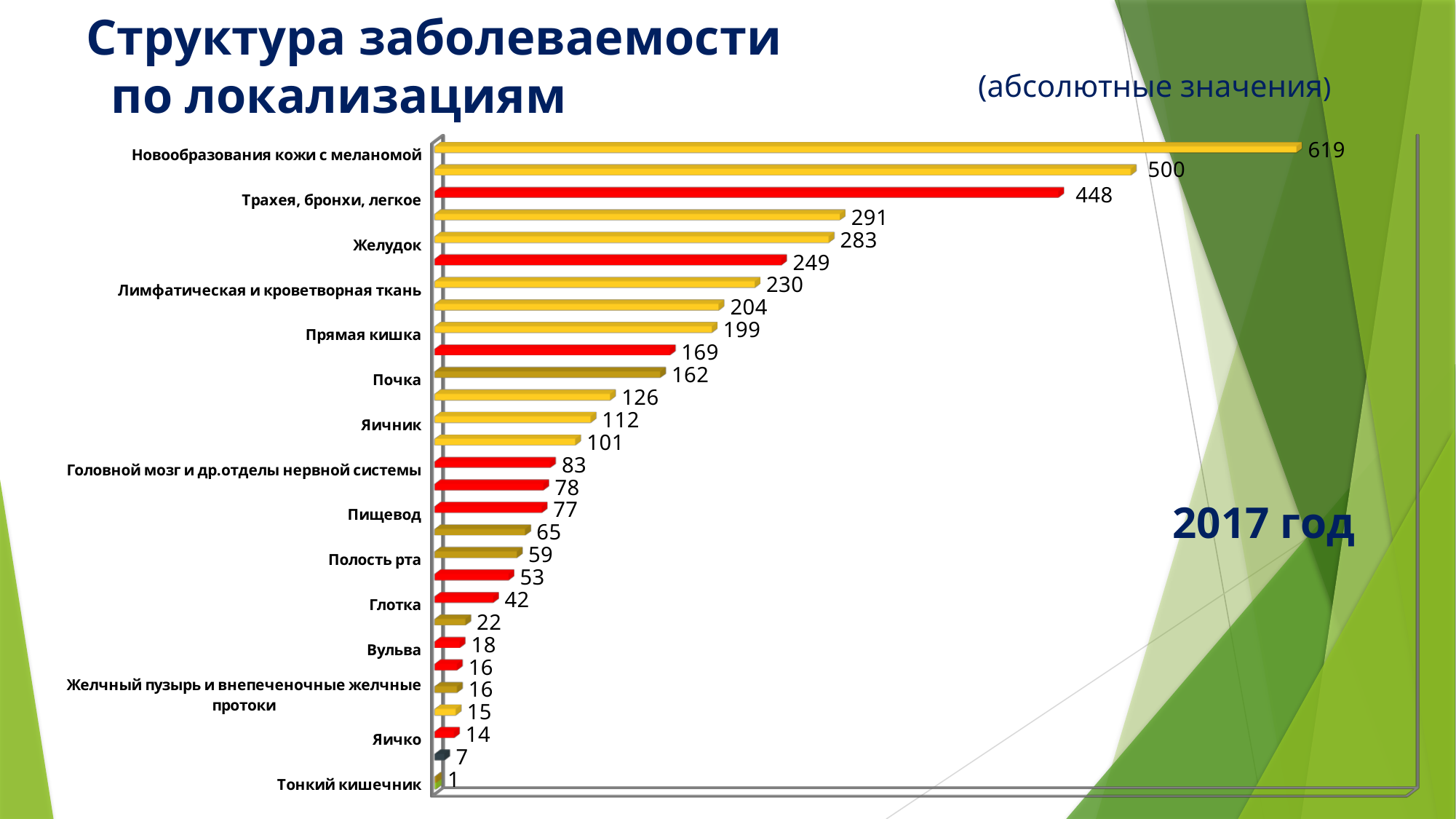
What is the value for Почка? 162 What is the difference between the values for Новообразования кожи с меланомой and Трахея, бронхи, легкое? 171 What kind of chart is shown on the slide? bar chart Which category has the lowest value in the chart? Тонкий кишечник Which year does the chart refer to, according to the slide? 2017 год What is the value for Трахея, бронхи, легкое? 448 Which is larger, the value for Желудок or the value for Лимфатическая и кроветворная ткань? Желудок What is the value for Прямая кишка? 199 What is the value for Новообразования кожи с меланомой? 619 What is the value for Глотка? 42 What is the value for Желудок? 283 Which category has the highest value in the chart? Новообразования кожи с меланомой